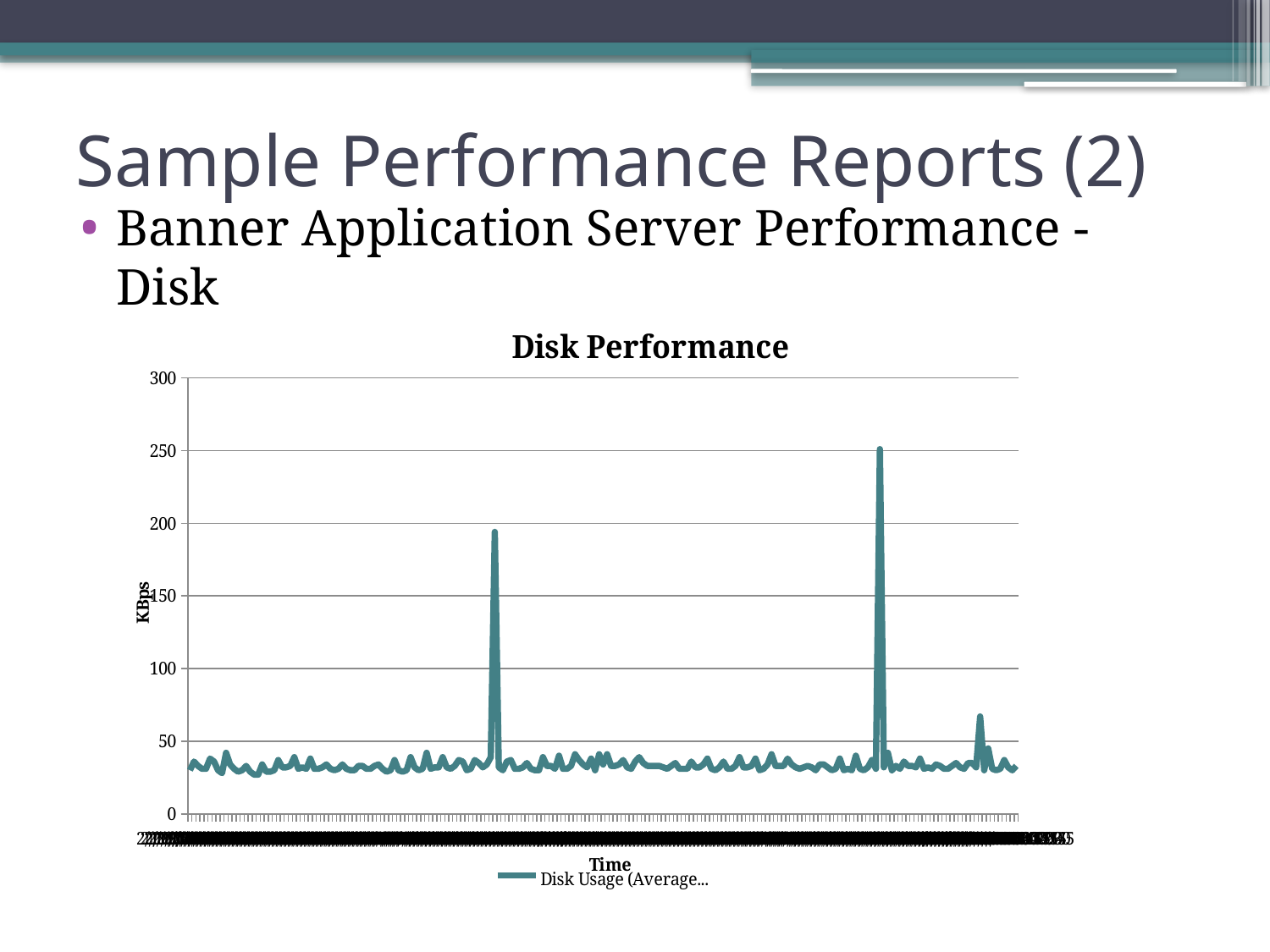
Is the typical baseline level of the Disk Usage line greater or less than 50? less What is the title of the chart? Disk Performance What kind of chart is shown on the slide? line chart Is the second-tallest spike of the Disk Usage line greater or less than 150? greater Is the second-tallest spike of the Disk Usage line greater or less than 250? less What label is shown on the vertical axis of the chart? KBps How many series does the chart's legend list? 1 What is the highest value shown on the vertical axis of the chart? 300 Which is larger: the tallest spike in the right half of the chart or the tallest spike in the left half? the spike in the right half